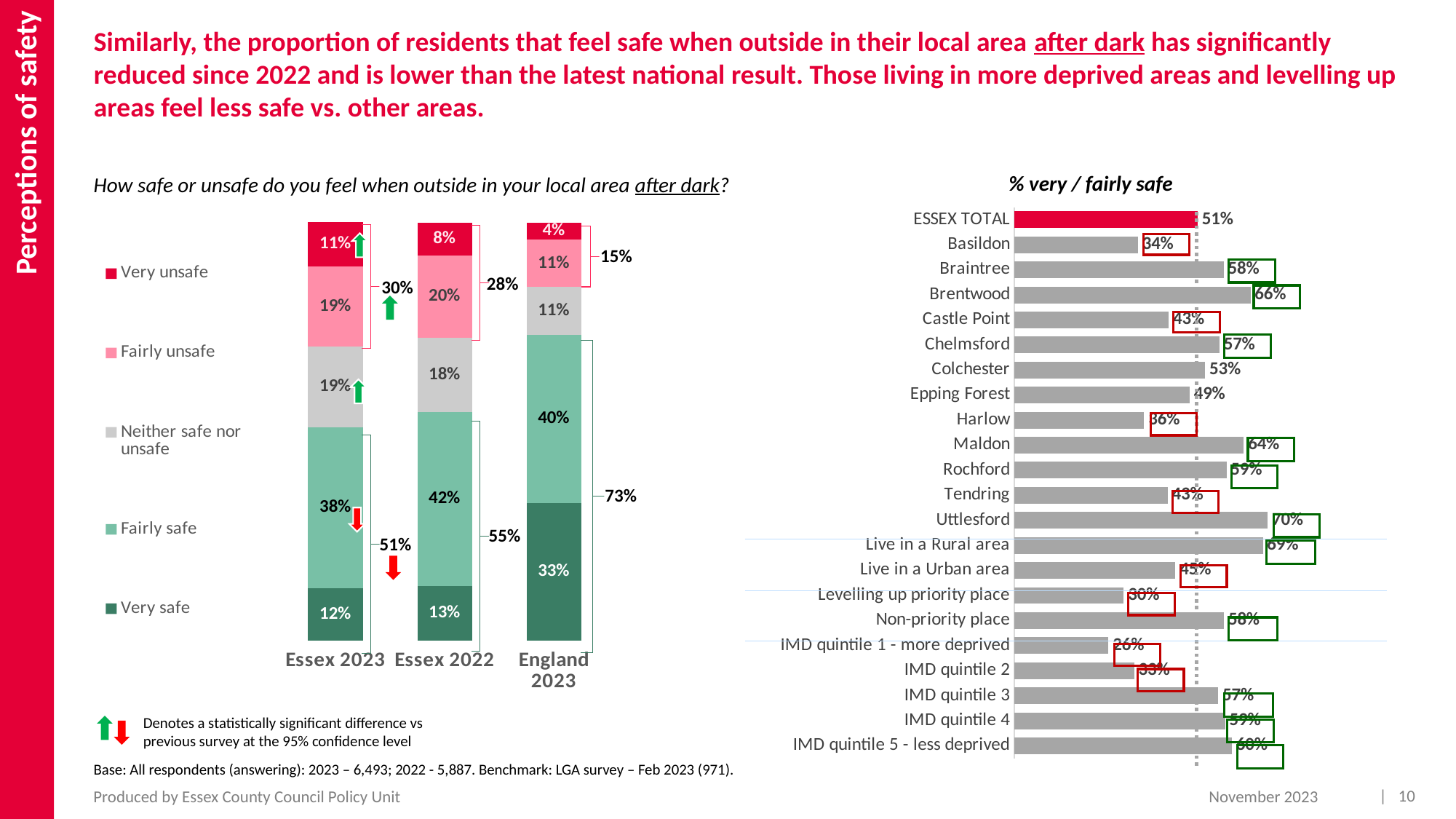
In the left stacked bar chart, how many percentage points higher is the very unsafe share for Essex 2023 than for Essex 2022? 3 percentage points In the left stacked bar chart, what percentage of England 2023 respondents said they feel very safe? 33% In the left stacked bar chart, what percentage of Essex 2022 respondents said they feel fairly safe? 42% In the '% very / fairly safe' chart, what is the value for ESSEX TOTAL? 51% In the '% very / fairly safe' chart, how many categories are plotted? 22 In the '% very / fairly safe' chart, which is higher, Brentwood or Maldon? Brentwood In the '% very / fairly safe' chart, which category has the lowest value? IMD quintile 1 - more deprived How many series does the legend of the left stacked bar chart list? 5 What kind of chart is the left chart about feeling safe after dark? Stacked bar chart In the '% very / fairly safe' chart, what is the difference between Braintree and Basildon? 24 percentage points In the '% very / fairly safe' chart, what is the value for Basildon? 34% In the left stacked bar chart, what is the combined very/fairly safe figure shown for Essex 2023? 51%